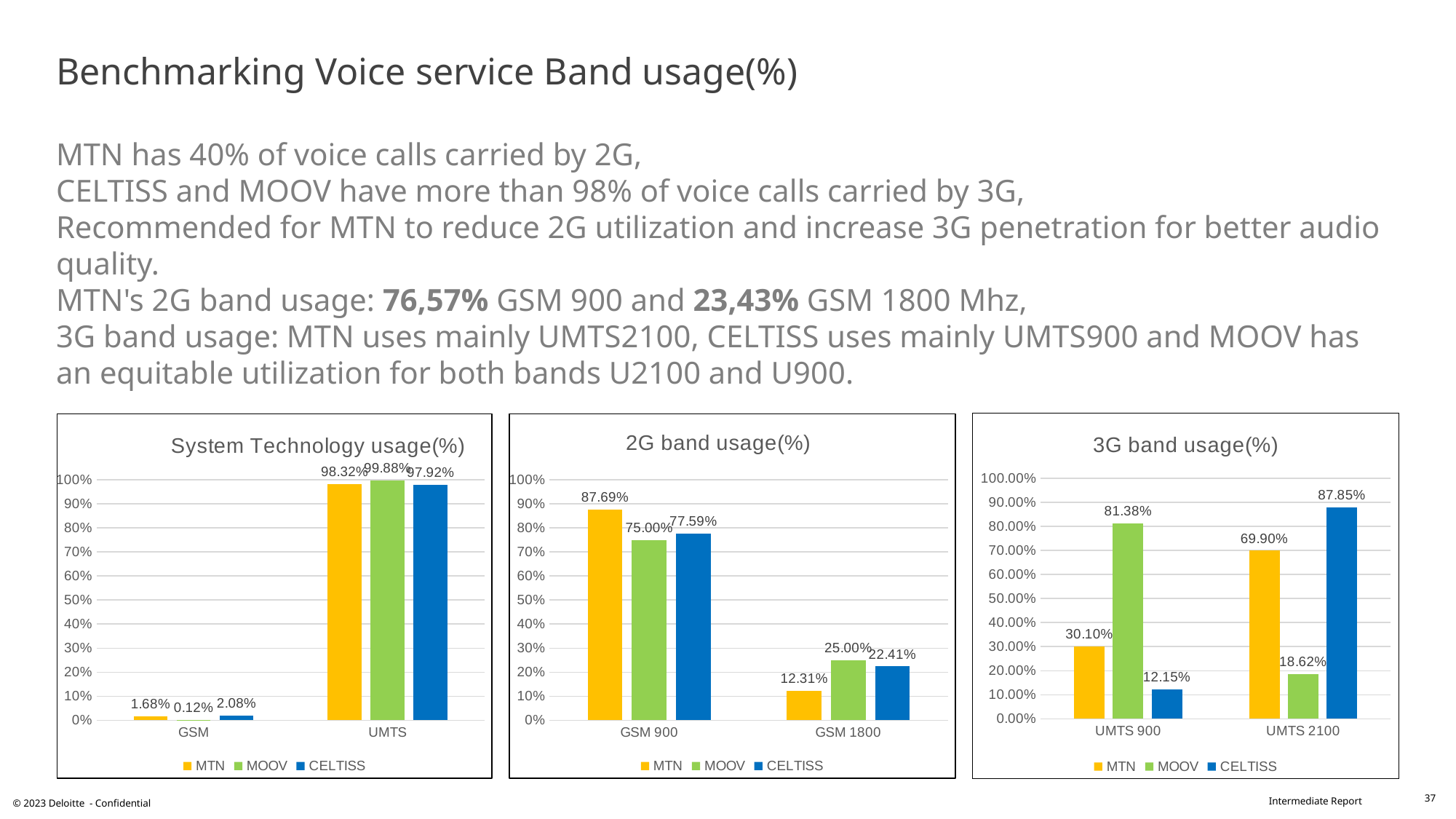
In the System Technology usage(%) chart, which operator has the lowest value at GSM? MOOV In the 2G band usage(%) chart, is the value for CELTISS at GSM 900 greater or less than 70%? greater How many categories are shown on the x axis of the 3G band usage(%) chart? 2 In the System Technology usage(%) chart, what is the value for CELTISS at GSM? 2.08% In the 3G band usage(%) chart, which operator has the highest value at UMTS 2100? CELTISS In the 3G band usage(%) chart, which colour represents CELTISS? Blue What type of chart is the System Technology usage(%) chart? Bar chart In the 2G band usage(%) chart, what is the difference between MOOV's GSM 1800 value and MTN's GSM 1800 value? 12.69% In the 2G band usage(%) chart, what is the value for MTN at GSM 900? 87.69% In the 3G band usage(%) chart, which is larger: MTN at UMTS 900 or MTN at UMTS 2100? MTN at UMTS 2100 In the 3G band usage(%) chart, what is the value for MOOV at UMTS 900? 81.38% How many series does the legend of the 2G band usage(%) chart list? 3